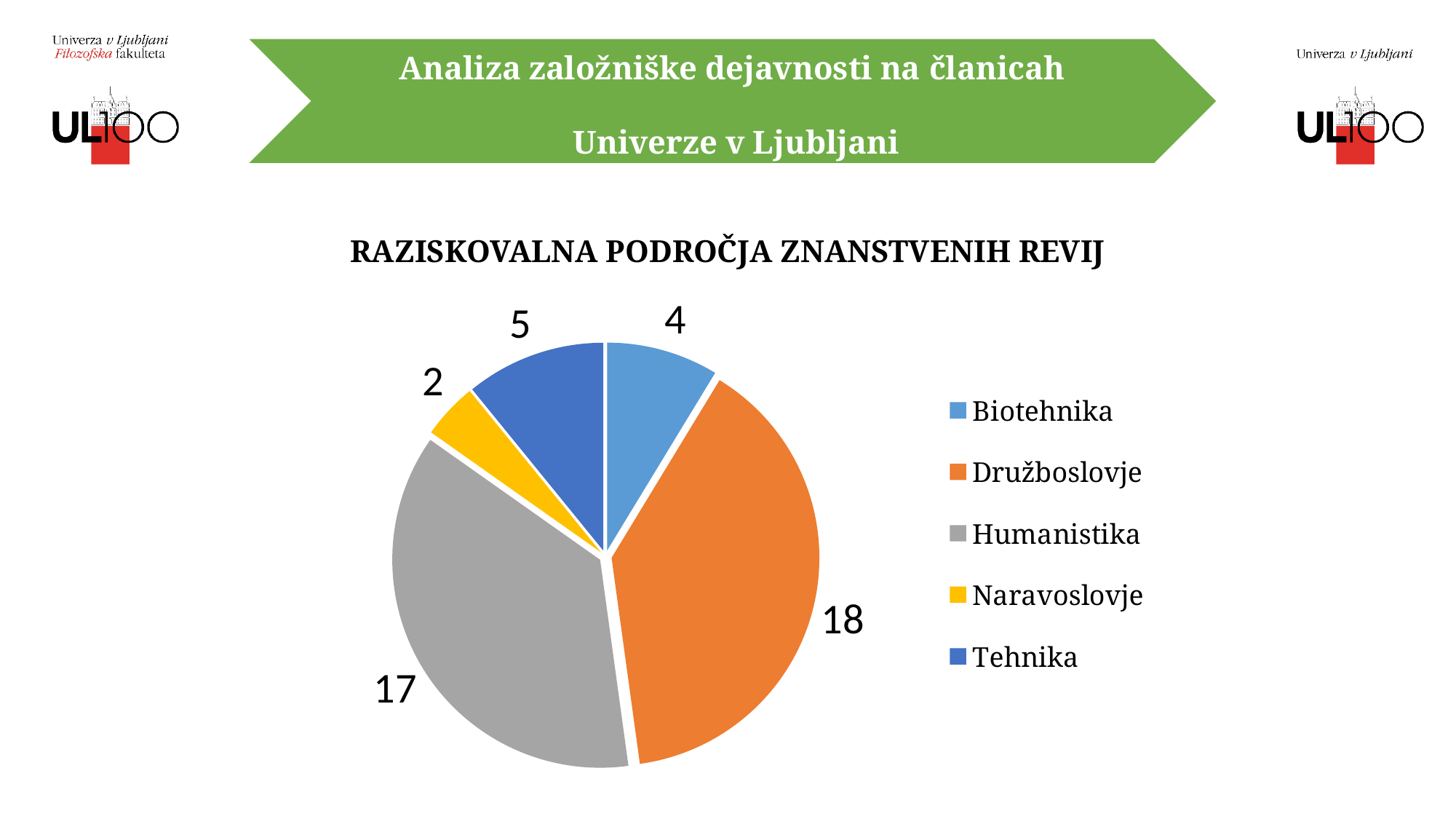
What is the title of the chart? RAZISKOVALNA PODROČJA ZNANSTVENIH REVIJ Which is larger, the value for Tehnika or the value for Biotehnika? Tehnika What is the total of all slices in the pie chart? 46 How many categories does the pie chart have? 5 Which category has the largest slice? Družboslovje What is the difference between the values for Družboslovje and Humanistika? 1 What is the value for Humanistika? 17 What is the value for Družboslovje? 18 Which category has the smallest slice? Naravoslovje What is the value for Biotehnika? 4 What type of chart is shown on the slide? pie chart What is the value for Tehnika? 5